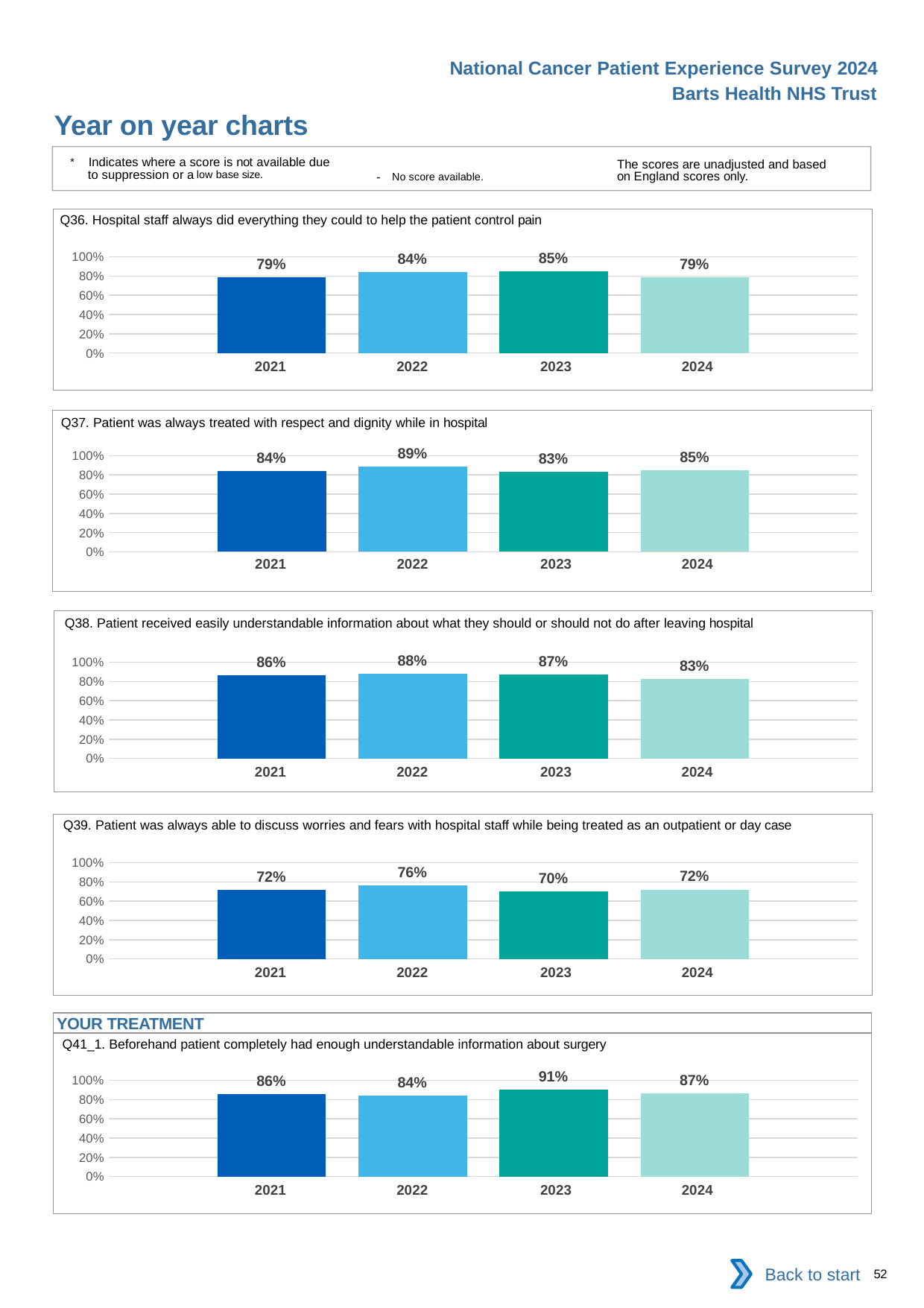
What kind of chart is the Q37 chart? bar chart In the Q38 chart, do the values rise or fall from 2022 to 2024? fall In the Q36 chart, what is the value for 2023? 85% In the Q41_1 chart, which is larger, the value for 2023 or the value for 2022? 2023 In the Q41_1 chart, what is the value for 2021? 86% In the Q36 chart, what is the difference between the 2023 and 2024 values? 6% What is the section heading shown above the Q41_1 chart? YOUR TREATMENT How many years are shown in the Q36 chart? 4 In the Q39 chart, what is the difference between the 2022 and 2023 values? 6% In the Q39 chart, is the value for 2023 greater or less than 80%? less In the Q37 chart, which year has the highest value? 2022 In the Q38 chart, which year has the lowest value? 2024